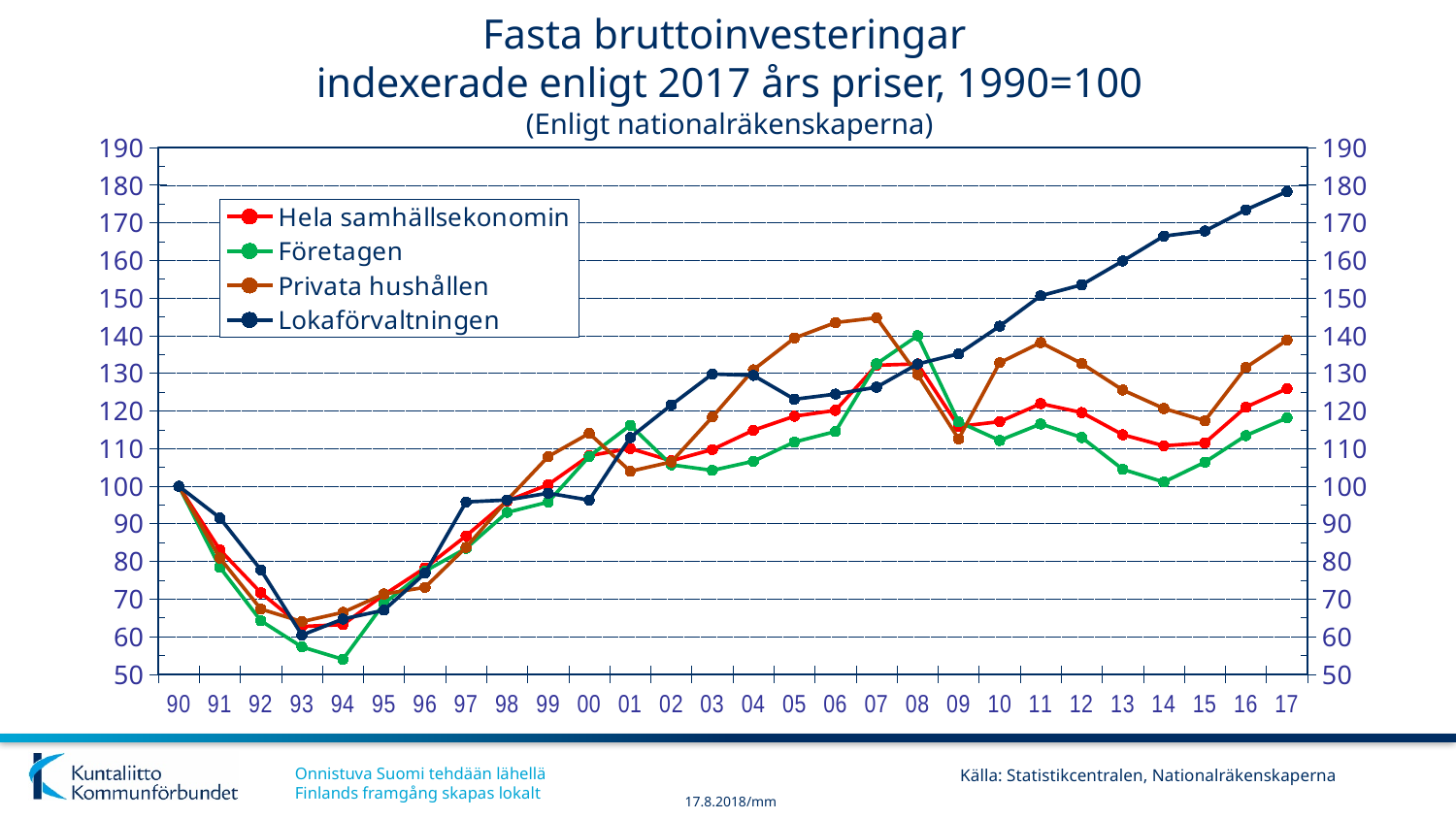
How many series does the legend list? 4 Does the Lokalförvaltningen series rise or fall from 09 to 17? rise How many years are plotted along the x axis? 28 Is the value for Privata hushållen in 07 greater or less than 140? greater What is the index value of all series in 1990 (90)? 100 Which series is drawn in red? Hela samhällsekonomin Which series has the lowest value in 94? Företagen Which series has the highest value in 17? Lokalförvaltningen Is the value for Lokalförvaltningen in 17 greater or less than 170? greater In 17, which is larger: Lokalförvaltningen or Företagen? Lokalförvaltningen What kind of chart is shown on the slide? line chart Is the value for Företagen in 94 greater or less than 60? less